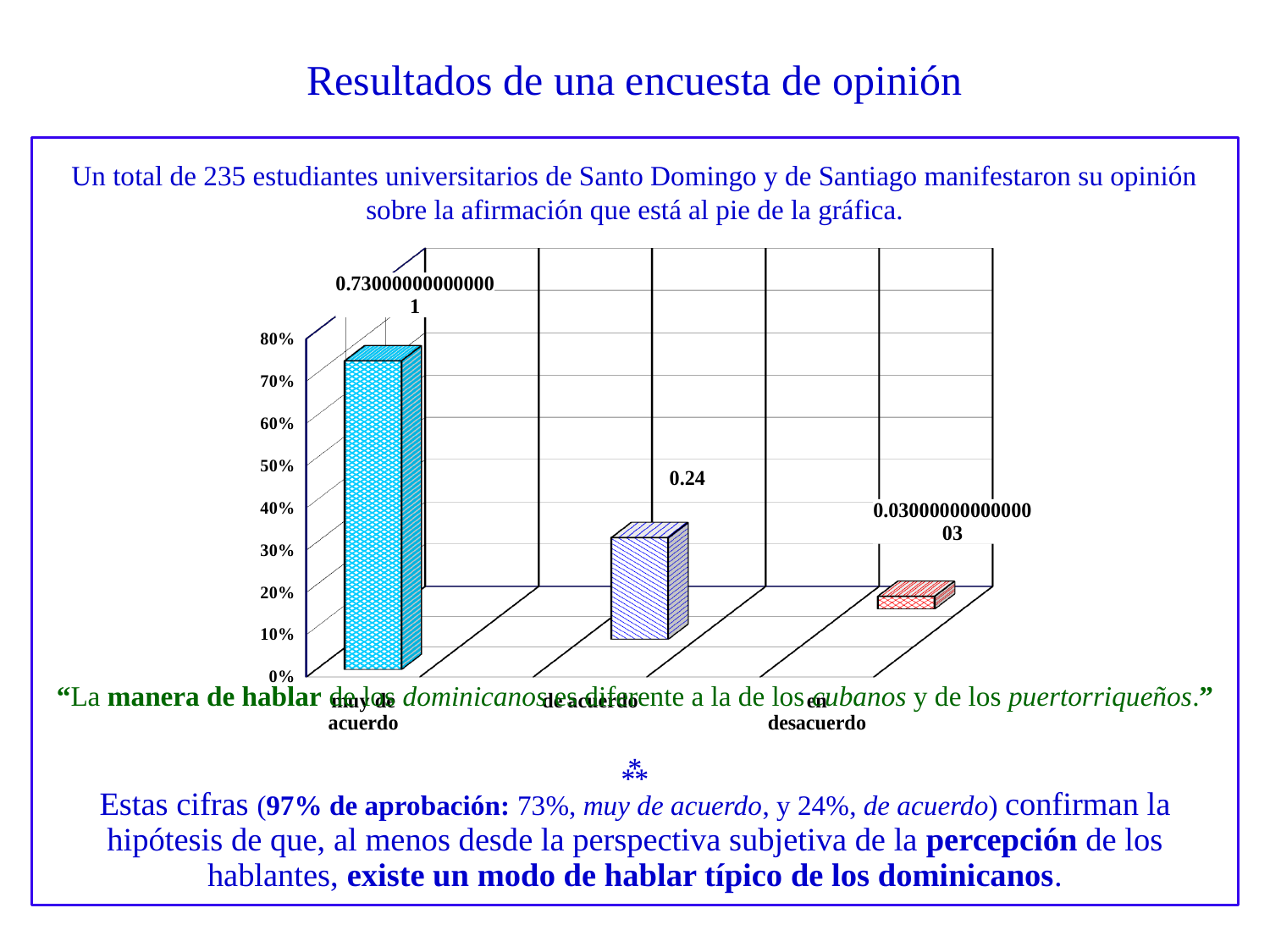
Which category has the lowest bar? en desacuerdo What is the title of the slide containing the chart? Resultados de una encuesta de opinión Which is larger, the value for 'de acuerdo' or the value for 'en desacuerdo'? de acuerdo What is the highest tick label shown on the vertical axis of the chart? 80% Is the value for 'de acuerdo' greater or less than 40%? less Is the value for 'en desacuerdo' greater or less than 10%? less Which category has the highest bar? muy de acuerdo Is the value for 'muy de acuerdo' greater or less than 60%? greater Do the bar values rise or fall from left to right along the x axis? fall What kind of chart is shown on the slide? bar chart What is the value shown for the 'de acuerdo' bar? 0.24 How many categories are plotted on the x axis of the chart? 3